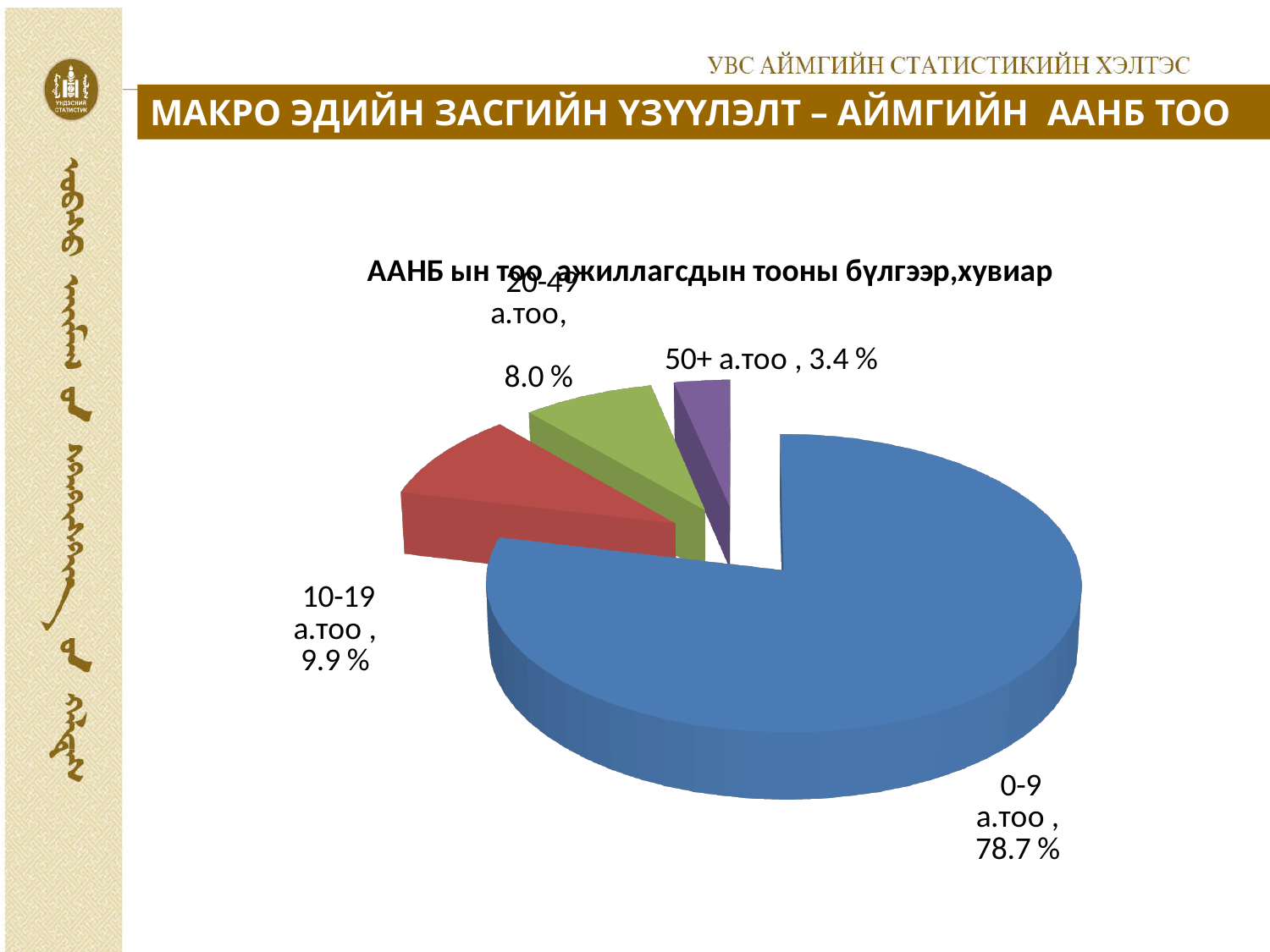
Which slice is larger, 20-49 а.тоо or 50+ а.тоо? 20-49 а.тоо What share of the pie does the 50+ а.тоо category have? 3.4 % Which category has the smallest slice of the pie? 50+ а.тоо What share of the pie does the 10-19 а.тоо category have? 9.9 % What colour is the slice for the 0-9 а.тоо category? Blue What share of the pie does the 0-9 а.тоо category have? 78.7 % What kind of chart is shown on the slide? Pie chart What is the title of the chart? ААНБ ын тоо ажиллагсдын тооны бүлгээр,хувиар What share of the pie does the 20-49 а.тоо category have? 8.0 % Which category has the largest slice of the pie? 0-9 а.тоо What is the difference in percentage points between the 10-19 а.тоо slice and the 20-49 а.тоо slice? 1.9 How many categories are shown in the pie chart? 4